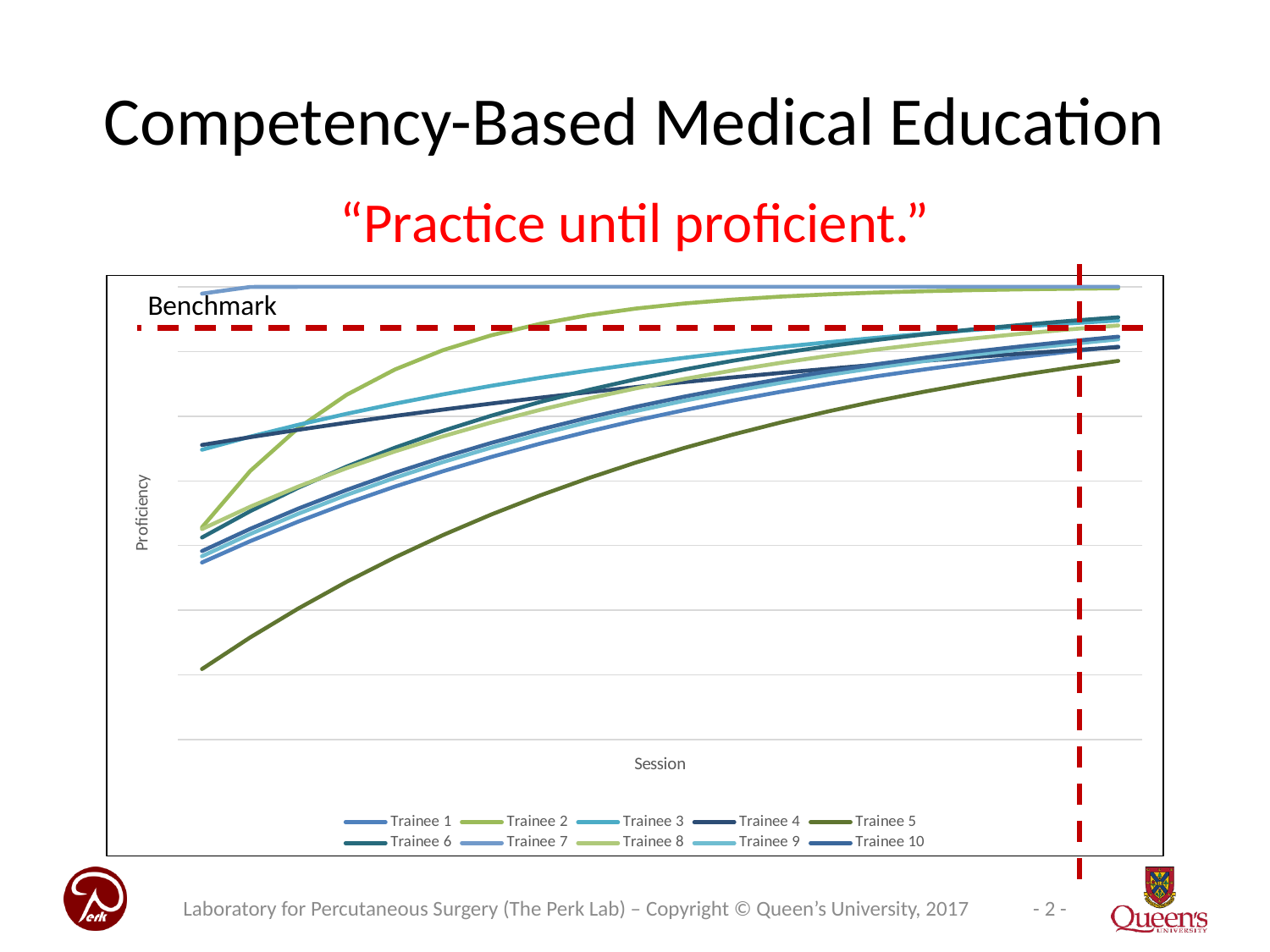
What is the label on the vertical axis of the chart? Proficiency Which trainee's line starts at the lowest proficiency at the first session? Trainee 5 How many series does the legend list? 10 What label is given to the horizontal dashed red line on the chart? Benchmark How many trainees are plotted on the chart? 10 Do the trainee proficiency lines rise or fall along the Session axis? rise What kind of chart is shown on the slide? line chart